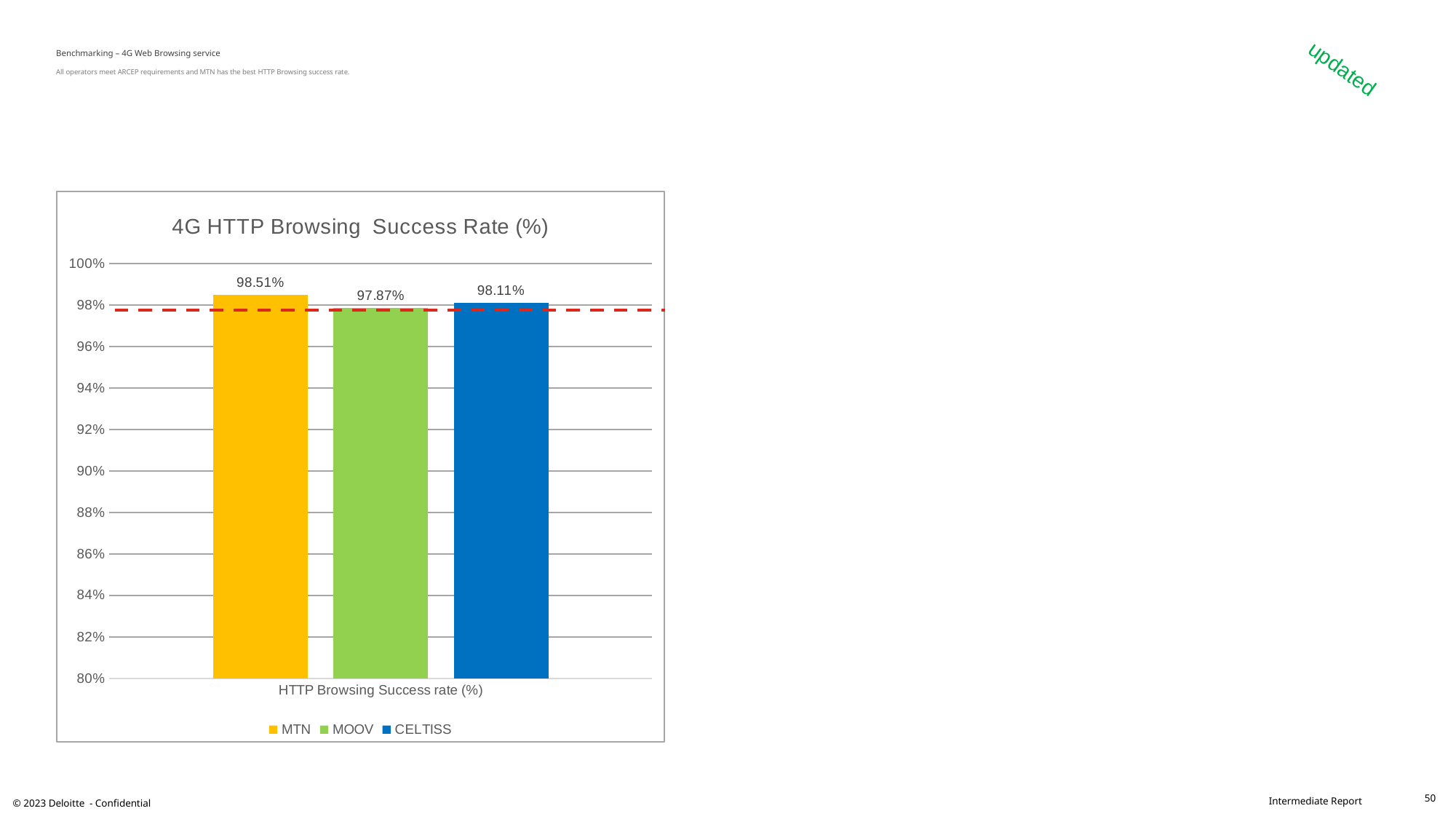
What is the 4G HTTP Browsing Success Rate for MTN? 98.51% Which operator has the highest 4G HTTP Browsing Success Rate? MTN What is the 4G HTTP Browsing Success Rate for CELTISS? 98.11% What is the difference between MTN's and MOOV's 4G HTTP Browsing Success Rate? 0.64% What kind of chart is shown on the slide? Bar chart What is the title of the chart? 4G HTTP Browsing Success Rate (%) Which has a higher 4G HTTP Browsing Success Rate, CELTISS or MOOV? CELTISS Is the value for MOOV greater or less than 98%? less What is the difference between CELTISS's and MOOV's 4G HTTP Browsing Success Rate? 0.24% What is the 4G HTTP Browsing Success Rate for MOOV? 97.87% Which operator has the lowest 4G HTTP Browsing Success Rate? MOOV How many series does the legend list? 3